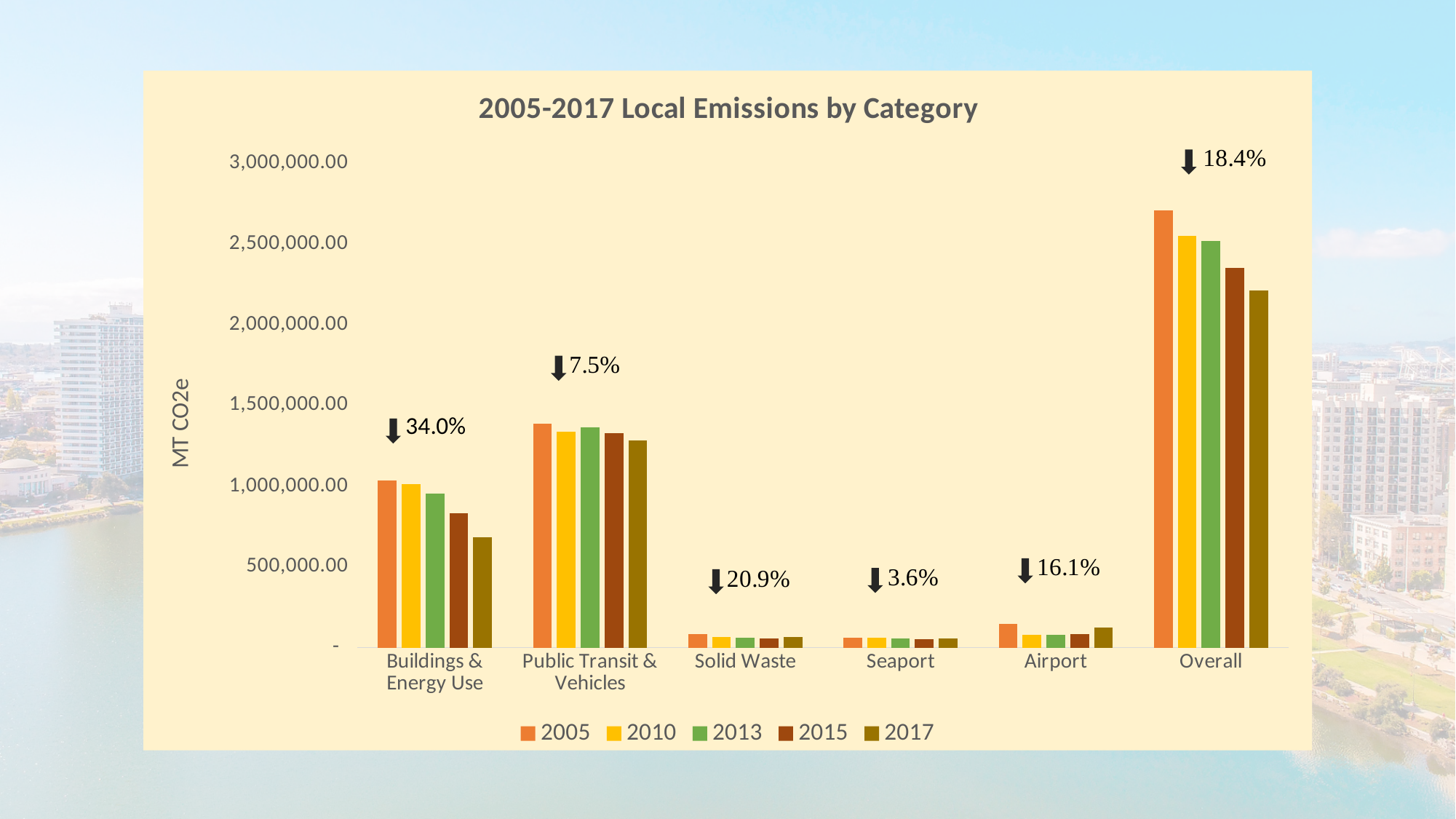
How many series does the legend list? 5 Which category has the largest labelled percentage decrease? Buildings & Energy Use What kind of chart is shown on the slide? bar chart How many categories are shown on the x axis? 6 Which category has the smallest labelled percentage decrease? Seaport Do the Buildings & Energy Use bars rise or fall from 2005 to 2017? fall What is the label on the vertical axis? MT CO2e Is the 2017 value for Buildings & Energy Use greater or less than 1,000,000.00? less What percentage decrease is labelled above the Buildings & Energy Use bars? 34.0% Is the 2005 value for Overall greater or less than 2,500,000.00? greater What percentage decrease is labelled above the Overall bars? 18.4% What percentage decrease is labelled above the Seaport bars? 3.6%